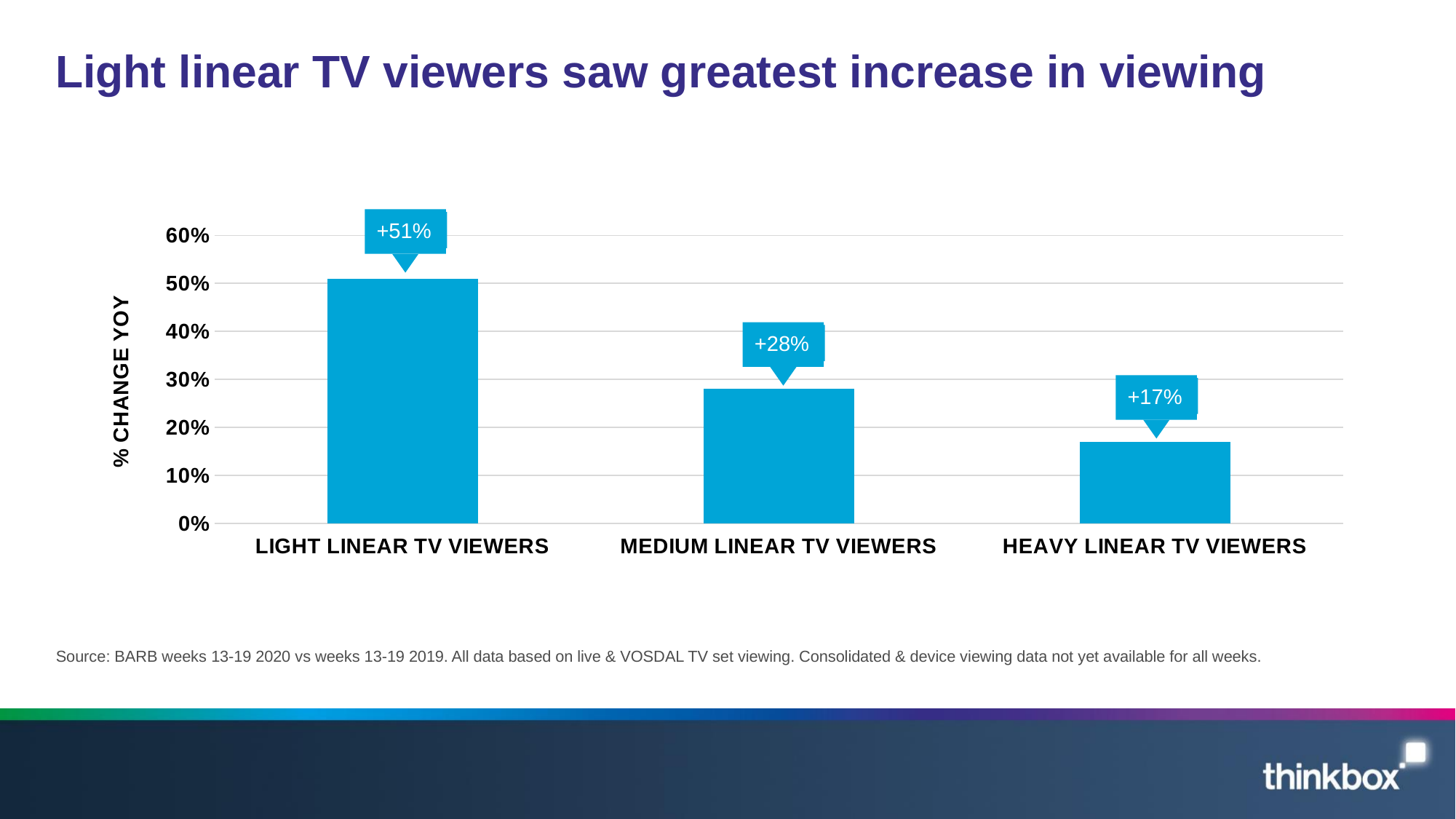
What is the % change YOY for Heavy linear TV viewers? +17% How many viewer groups are shown on the chart? 3 What is the difference in % change YOY between Light linear TV viewers and Medium linear TV viewers? 23 percentage points What is the difference in % change YOY between Light linear TV viewers and Heavy linear TV viewers? 34 percentage points What is the % change YOY for Light linear TV viewers? +51% What kind of chart is shown on the slide? Bar chart Is the value for Medium linear TV viewers greater or less than 30%? less Which has a larger % change YOY, Medium linear TV viewers or Heavy linear TV viewers? Medium linear TV viewers What is the label on the vertical axis of the chart? % CHANGE YOY Which viewer group has the highest % change YOY? Light linear TV viewers What is the % change YOY for Medium linear TV viewers? +28% Which viewer group has the lowest % change YOY? Heavy linear TV viewers